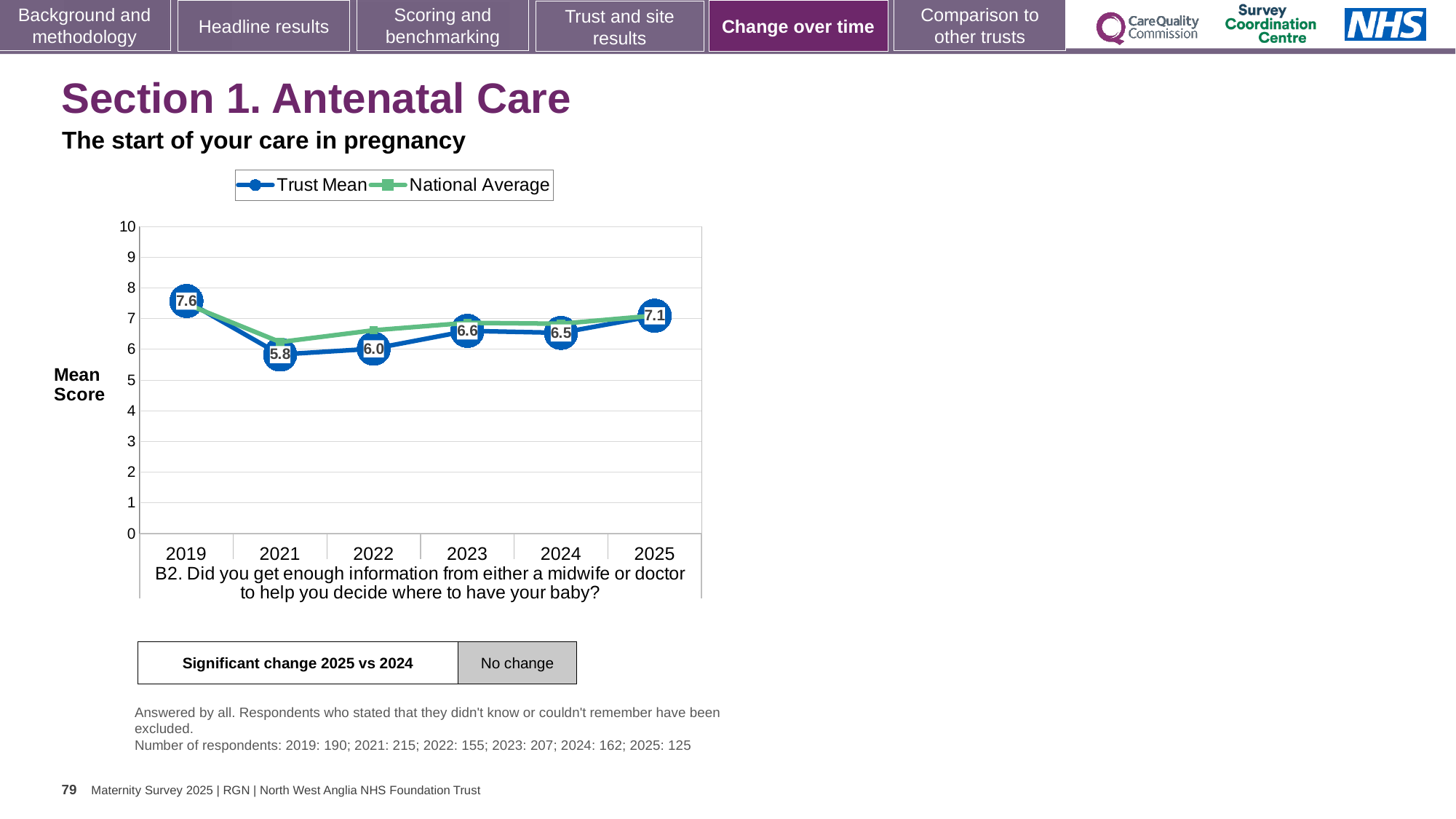
What is the difference between the Trust Mean scores for 2019 and 2021? 1.8 What is the Trust Mean score for 2025? 7.1 What kind of chart is shown on the slide? line chart In which year is the Trust Mean score lowest? 2021 Is the National Average for 2021 greater or less than 7? less Does the Trust Mean rise or fall from 2021 to 2025? rise How many series does the legend list? 2 What is the Trust Mean score for 2022? 6.0 Which is larger, the Trust Mean score for 2023 or for 2024? 2023 In which year is the Trust Mean score highest? 2019 How many years are plotted on the x axis? 6 What is the Trust Mean score for 2019? 7.6